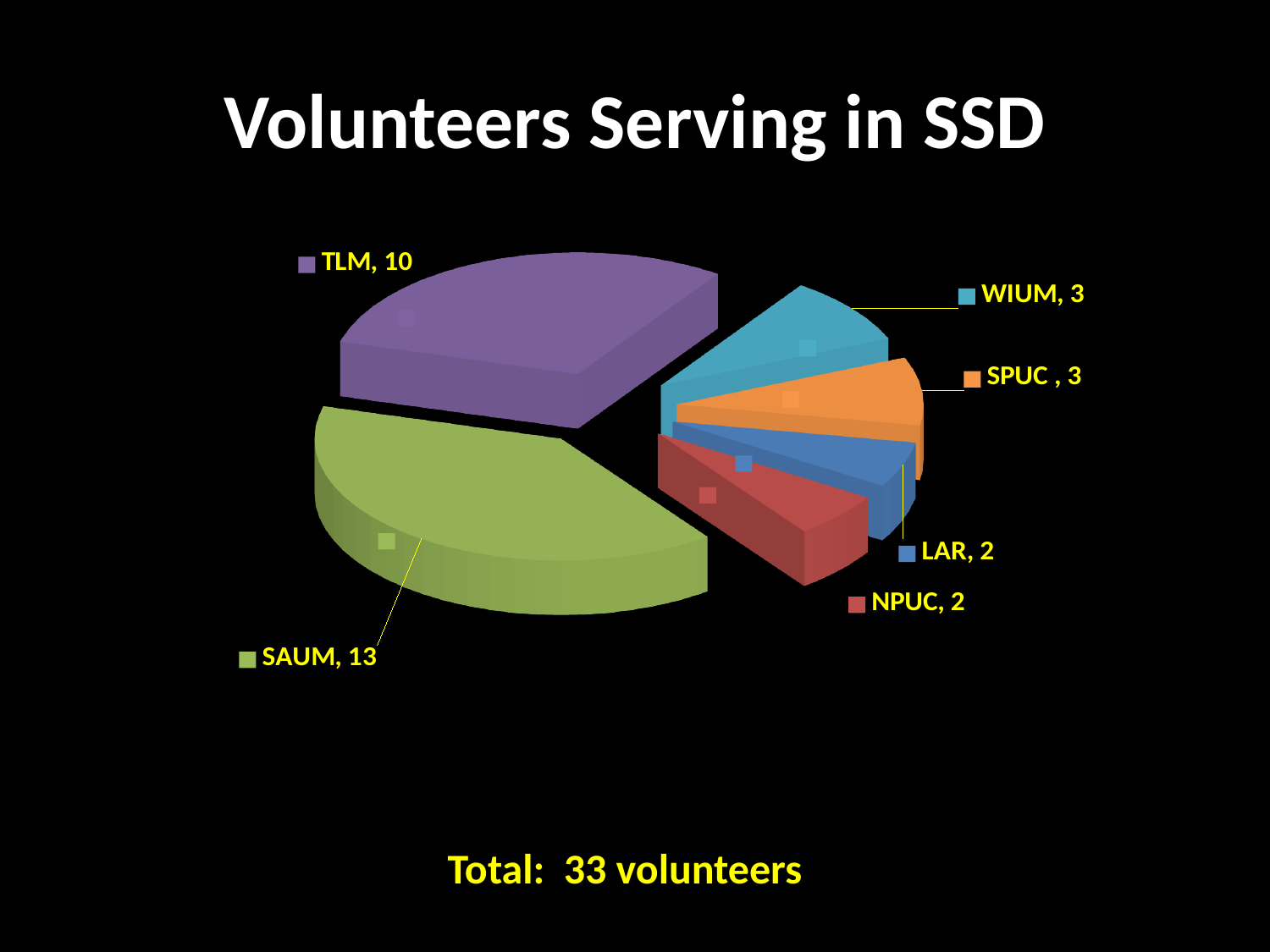
What type of chart is shown on the slide? Pie chart What is the value shown for WIUM? 3 What is the value shown for TLM? 10 What is the value shown for NPUC? 2 What is the difference between the SAUM value and the TLM value? 3 Which category has the largest slice of the pie? SAUM What total number of volunteers is stated on the slide? 33 volunteers How many categories (slices) are in the pie chart? 6 What is the title of the chart? Volunteers Serving in SSD Which is larger, the value for SPUC or the value for LAR? SPUC Which categories have the smallest value in the pie chart? LAR and NPUC How many volunteers does the SAUM slice represent? 13